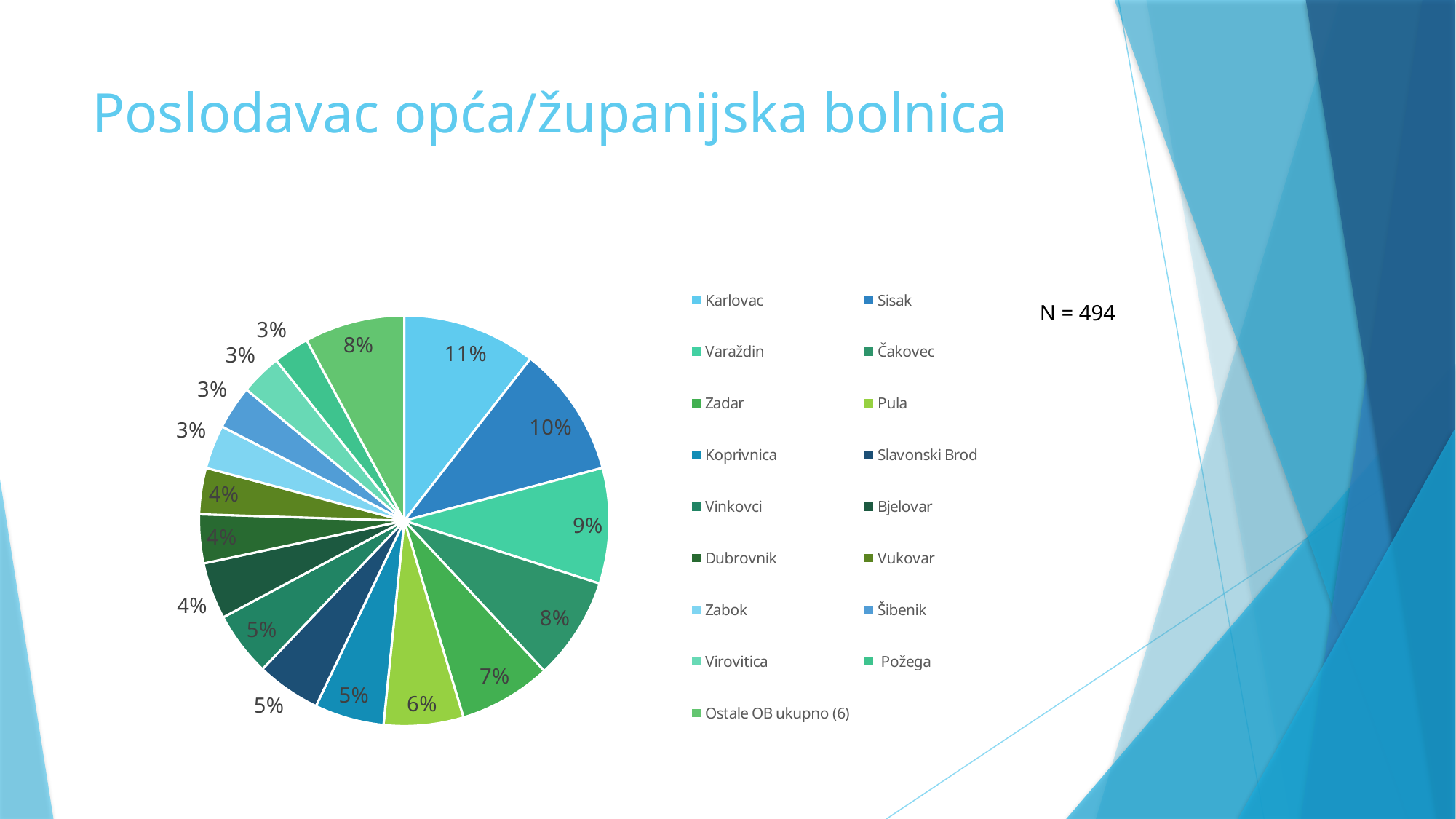
Which category has the largest slice of the pie? Karlovac What share of the pie does Karlovac have? 11% What share of the pie does Sisak have? 10% What type of chart is shown on the slide? pie chart What is the difference between the shares of Karlovac and Sisak? 1% Which has a larger share, Karlovac or Varaždin? Karlovac What is the value of N stated on the slide? 494 What share of the pie does Varaždin have? 9% What is the smallest percentage shown on any slice of the pie? 3% How many categories does the legend list? 17 What share of the pie does Ostale OB ukupno (6) have? 8% What share of the pie does Pula have? 6%